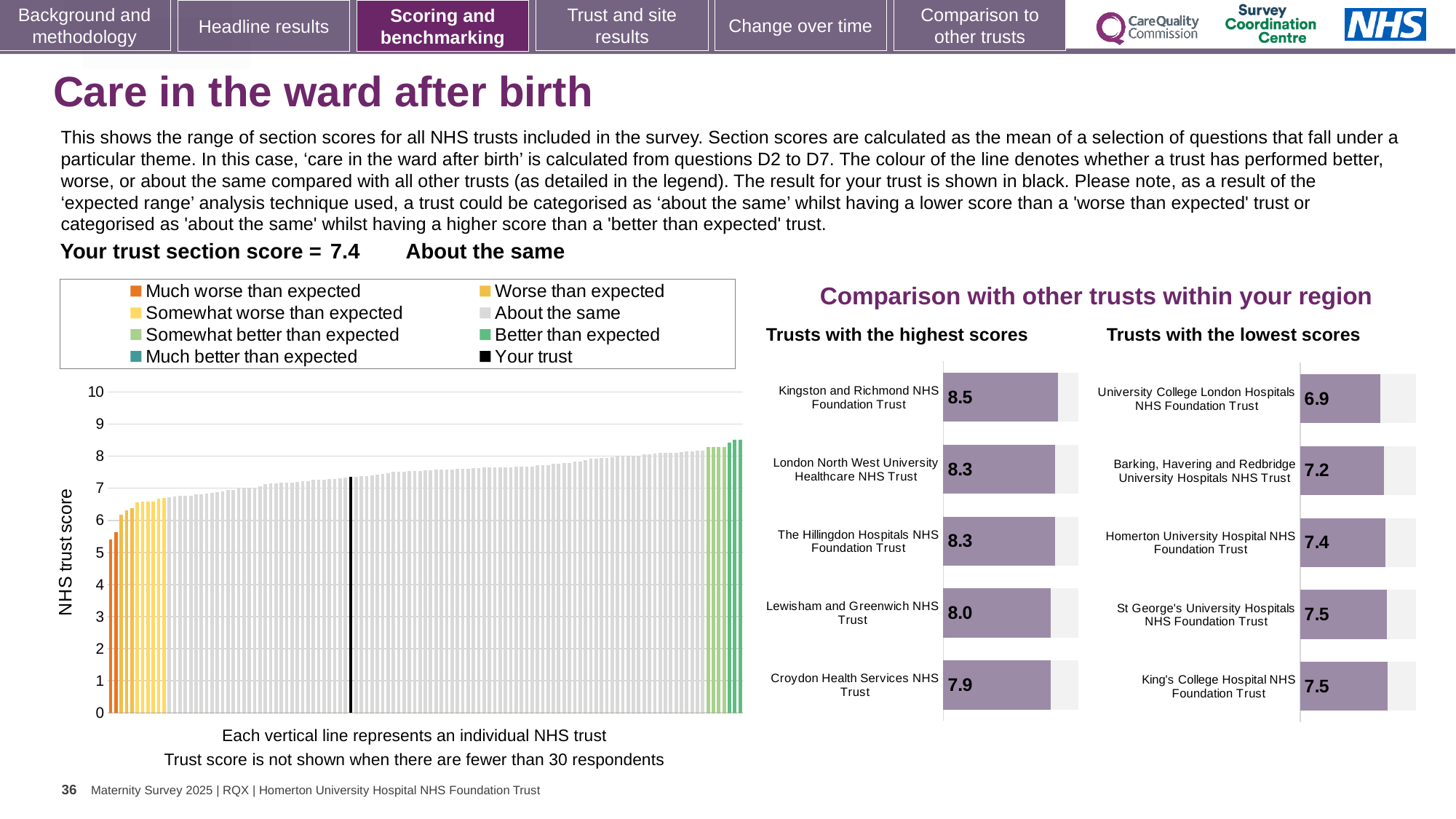
In the 'Trusts with the lowest scores' chart, what is the score for University College London Hospitals NHS Foundation Trust? 6.9 In the 'Trusts with the highest scores' chart, what is the score for Croydon Health Services NHS Trust? 7.9 In the 'Trusts with the lowest scores' chart, which trust has the lowest score? University College London Hospitals NHS Foundation Trust In the large chart on the left, is the value for the black bar (Your trust) greater or less than 7? greater In the 'Trusts with the highest scores' chart, what is the difference between the scores of Kingston and Richmond NHS Foundation Trust and Croydon Health Services NHS Trust? 0.6 In the 'Trusts with the lowest scores' chart, which has the larger score: Barking, Havering and Redbridge University Hospitals NHS Trust or Homerton University Hospital NHS Foundation Trust? Homerton University Hospital NHS Foundation Trust In the 'Trusts with the lowest scores' chart, what is the score for Homerton University Hospital NHS Foundation Trust? 7.4 How many trusts are shown in the 'Trusts with the lowest scores' chart? 5 In the 'Trusts with the highest scores' chart, what is the score for Kingston and Richmond NHS Foundation Trust? 8.5 In the 'Trusts with the highest scores' chart, which trust has the highest score? Kingston and Richmond NHS Foundation Trust How many entries does the legend of the large chart on the left list? 8 What kind of chart is the large chart on the left with the 'NHS trust score' axis? Bar chart